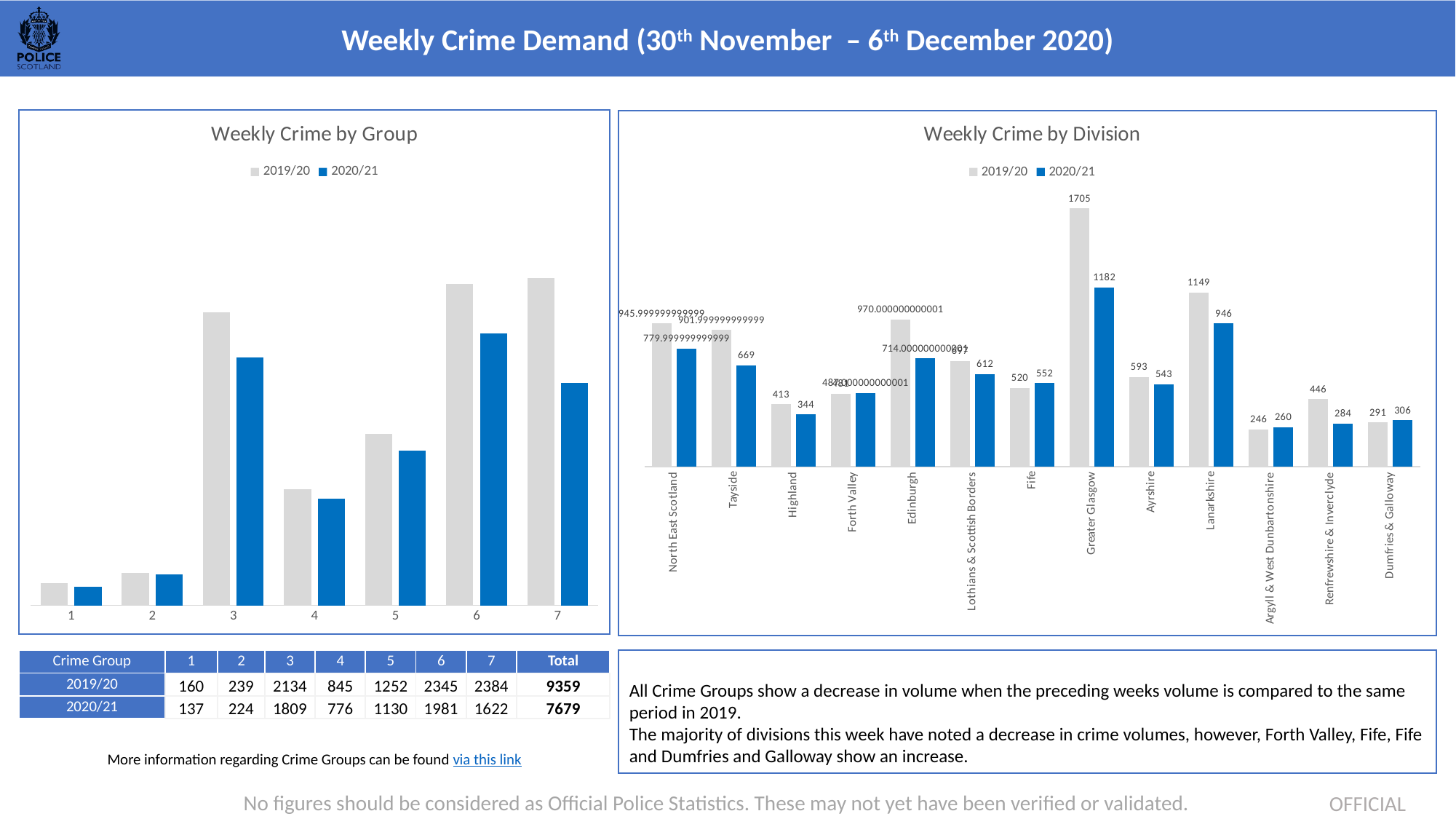
In the Weekly Crime by Division chart, which division has the highest 2019/20 value? Greater Glasgow In the Weekly Crime by Group chart, which crime group has the highest 2020/21 value? 6 In the Weekly Crime by Division chart, what is the difference between the 2019/20 and 2020/21 values for Greater Glasgow? 523 How many divisions are shown in the Weekly Crime by Division chart? 13 In the Weekly Crime by Division chart, which division has the lowest 2019/20 value? Argyll & West Dunbartonshire What kind of chart is the Weekly Crime by Group chart? Bar chart In the Weekly Crime by Division chart, what is the 2019/20 value for Greater Glasgow? 1705 In the Weekly Crime by Division chart, is the 2019/20 or the 2020/21 value larger for Fife? 2020/21 In the Weekly Crime by Division chart, what is the 2019/20 value for Ayrshire? 593 How many series does the legend of the Weekly Crime by Group chart list? 2 In the Weekly Crime by Division chart, what is the 2020/21 value for Lanarkshire? 946 In the Weekly Crime by Division chart, what is the difference between the 2019/20 and 2020/21 values for Renfrewshire & Inverclyde? 162